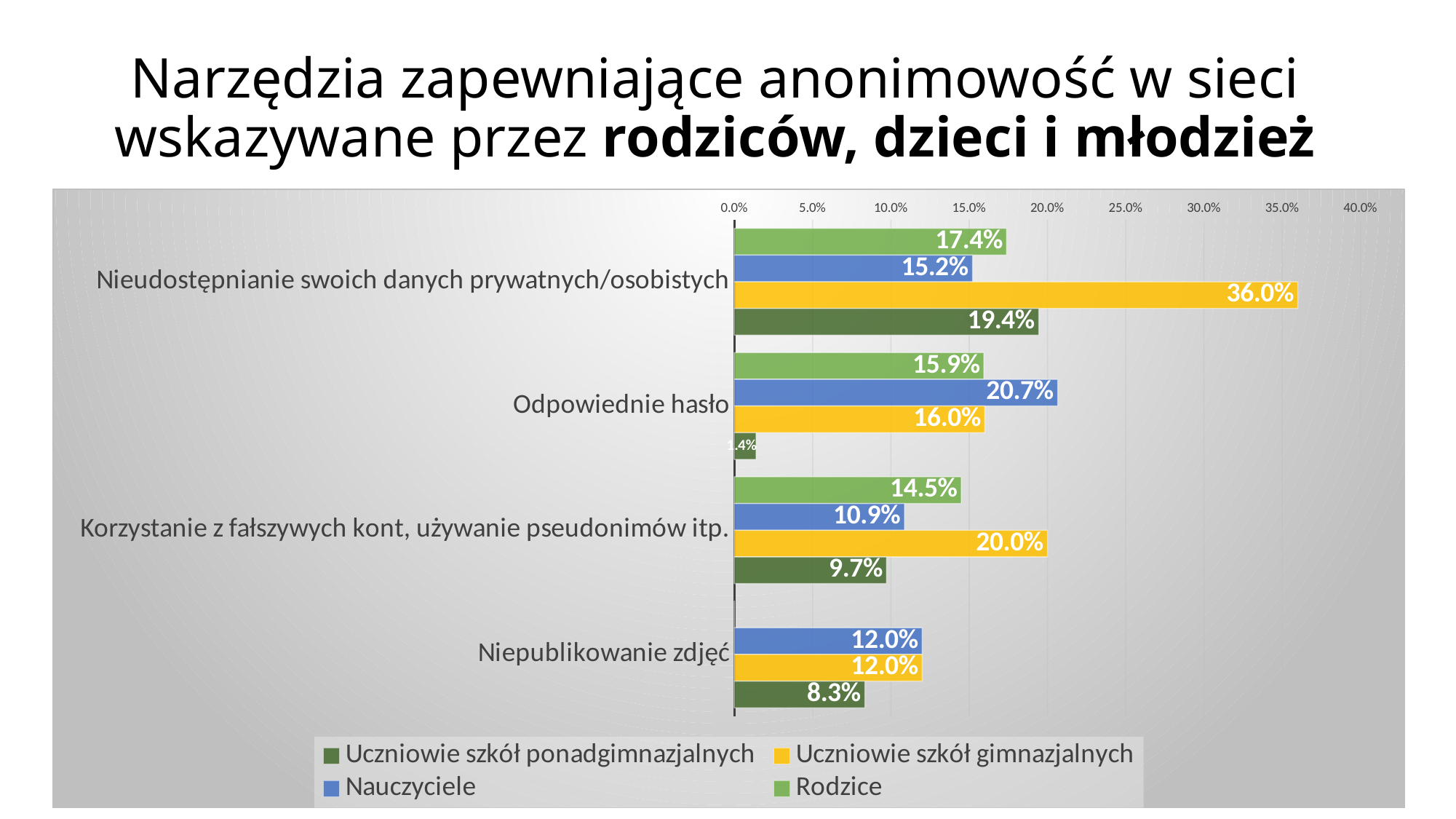
What is the value for Uczniowie szkół ponadgimnazjalnych in the category 'Niepublikowanie zdjęć'? 8.3% What is the difference between the Uczniowie szkół gimnazjalnych value and the Nauczyciele value in the category 'Korzystanie z fałszywych kont, używanie pseudonimów itp.'? 9.1% Which series has the highest value in the category 'Nieudostępnianie swoich danych prywatnych/osobistych'? Uczniowie szkół gimnazjalnych What kind of chart is shown on the slide? bar chart Which series is shown in yellow in the legend? Uczniowie szkół gimnazjalnych Which series has the lowest value in the category 'Odpowiednie hasło'? Uczniowie szkół ponadgimnazjalnych How many categories are shown on the chart? 4 How many series does the legend list? 4 In the category 'Nieudostępnianie swoich danych prywatnych/osobistych', which is larger: the value for Rodzice or the value for Nauczyciele? Rodzice What is the value for Nauczyciele in the category 'Odpowiednie hasło'? 20.7% What is the value for Uczniowie szkół gimnazjalnych in the category 'Nieudostępnianie swoich danych prywatnych/osobistych'? 36.0% What is the value for Rodzice in the category 'Korzystanie z fałszywych kont, używanie pseudonimów itp.'? 14.5%